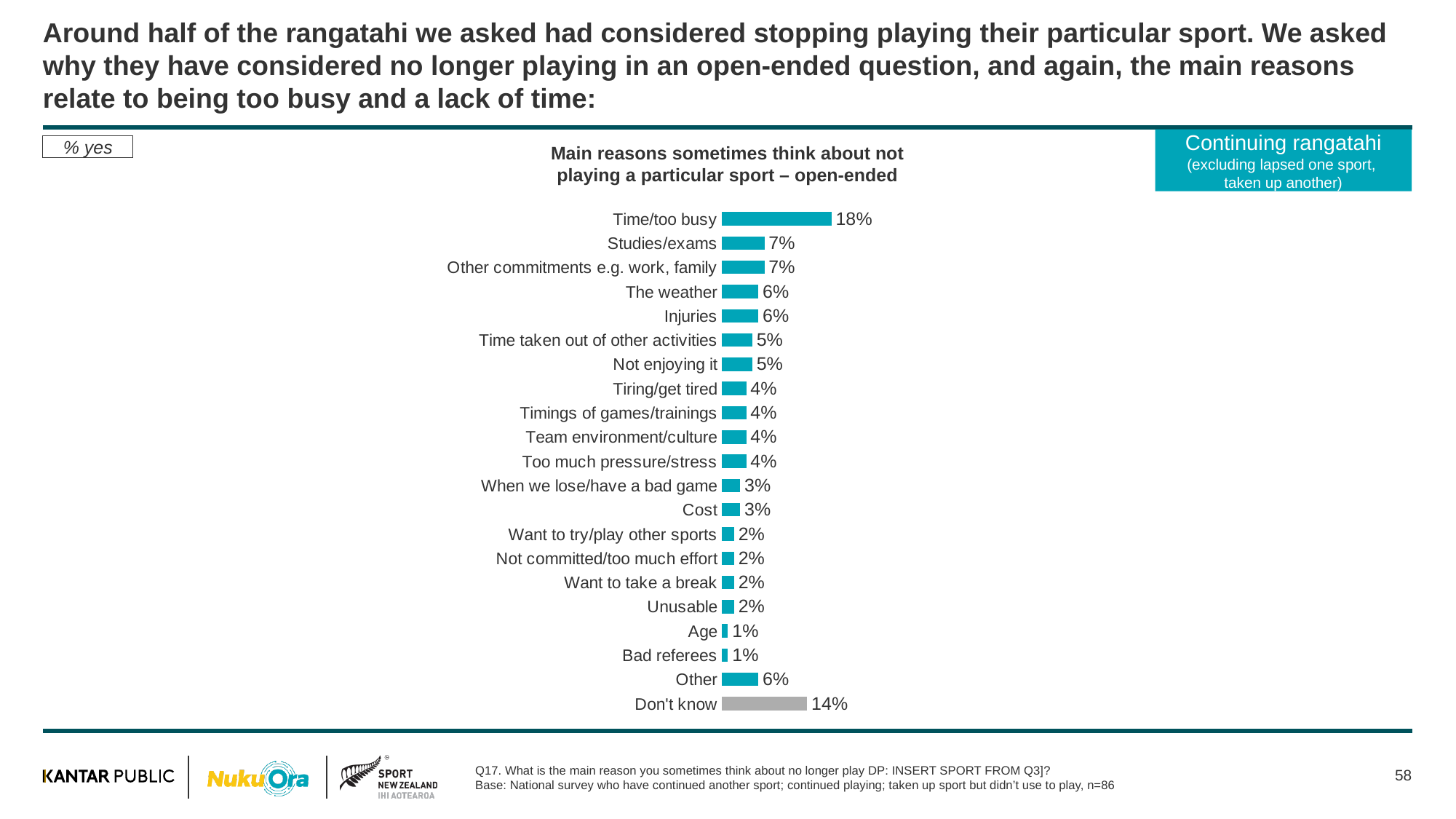
What is the value for Bad referees? 1% What is the value for Injuries? 6% What is the difference between Time/too busy and Studies/exams? 11% What is the title of the chart? Main reasons sometimes think about not playing a particular sport – open-ended Which is larger, The weather or Not enjoying it? The weather What is the difference between Don't know and Other? 8% What is the value for Cost? 3% Which reason has the highest value? Time/too busy What kind of chart is shown on the slide? Bar chart What is the value for Don't know? 14% What is the value for Time/too busy? 18% How many categories are shown in the chart? 21